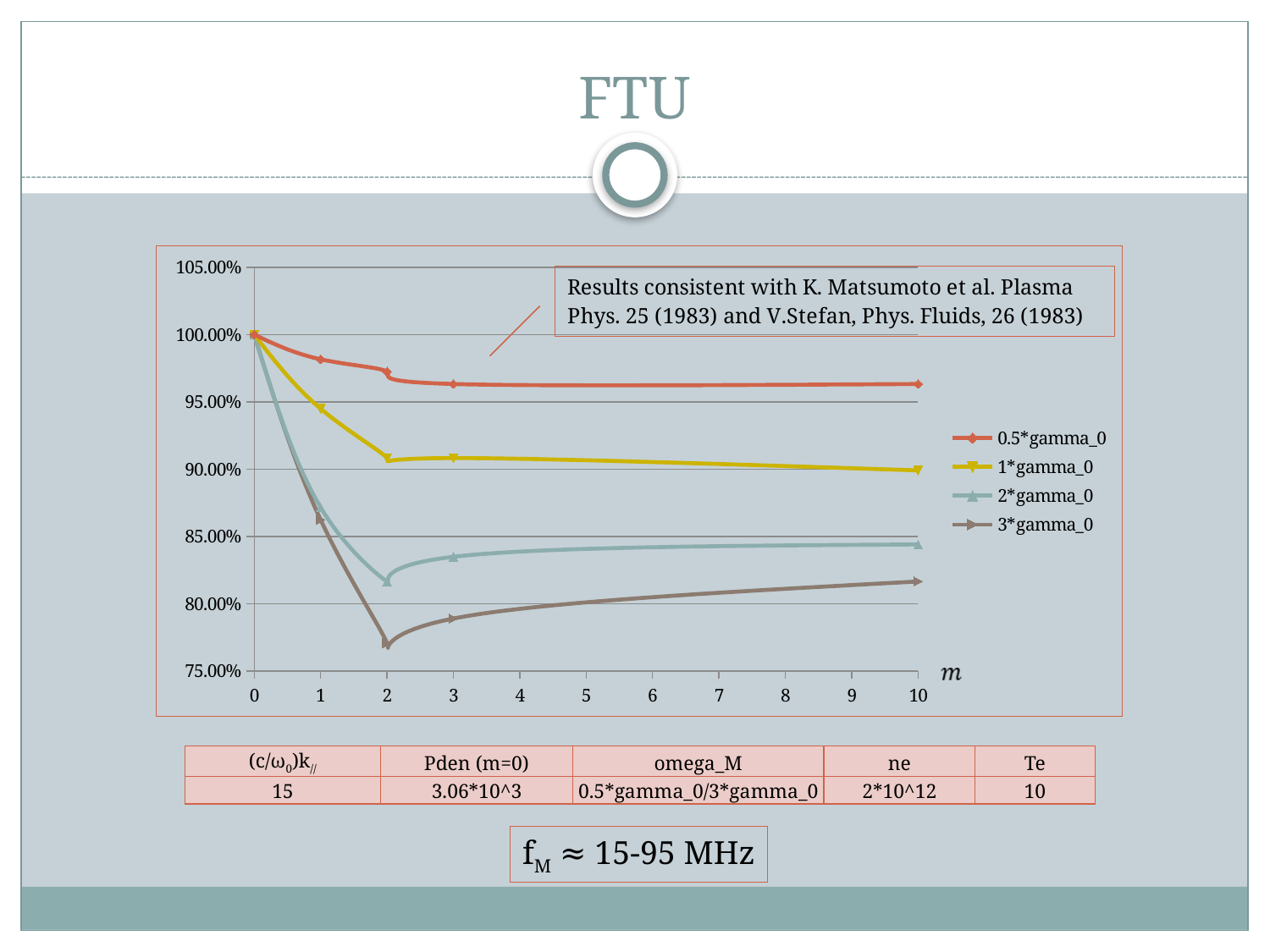
What kind of chart is shown on the slide? line chart Does the 3*gamma_0 series rise or fall between m = 0 and m = 2? fall At m = 3, which series has the larger value, 1*gamma_0 or 2*gamma_0? 1*gamma_0 Is the value of the 0.5*gamma_0 series at m = 10 greater or less than 95.00%? greater What is the value of the 3*gamma_0 series at m = 0? 100.00% Is the value of the 3*gamma_0 series at m = 2 greater or less than 80.00%? less What is the value of the 0.5*gamma_0 series at m = 0? 100.00% Which series has the highest value at m = 10? 0.5*gamma_0 Which series has the lowest value at m = 2? 3*gamma_0 Is the value of the 2*gamma_0 series at m = 2 greater or less than 80.00%? greater How many series does the chart legend list? 4 What is the label on the x axis of the chart? m